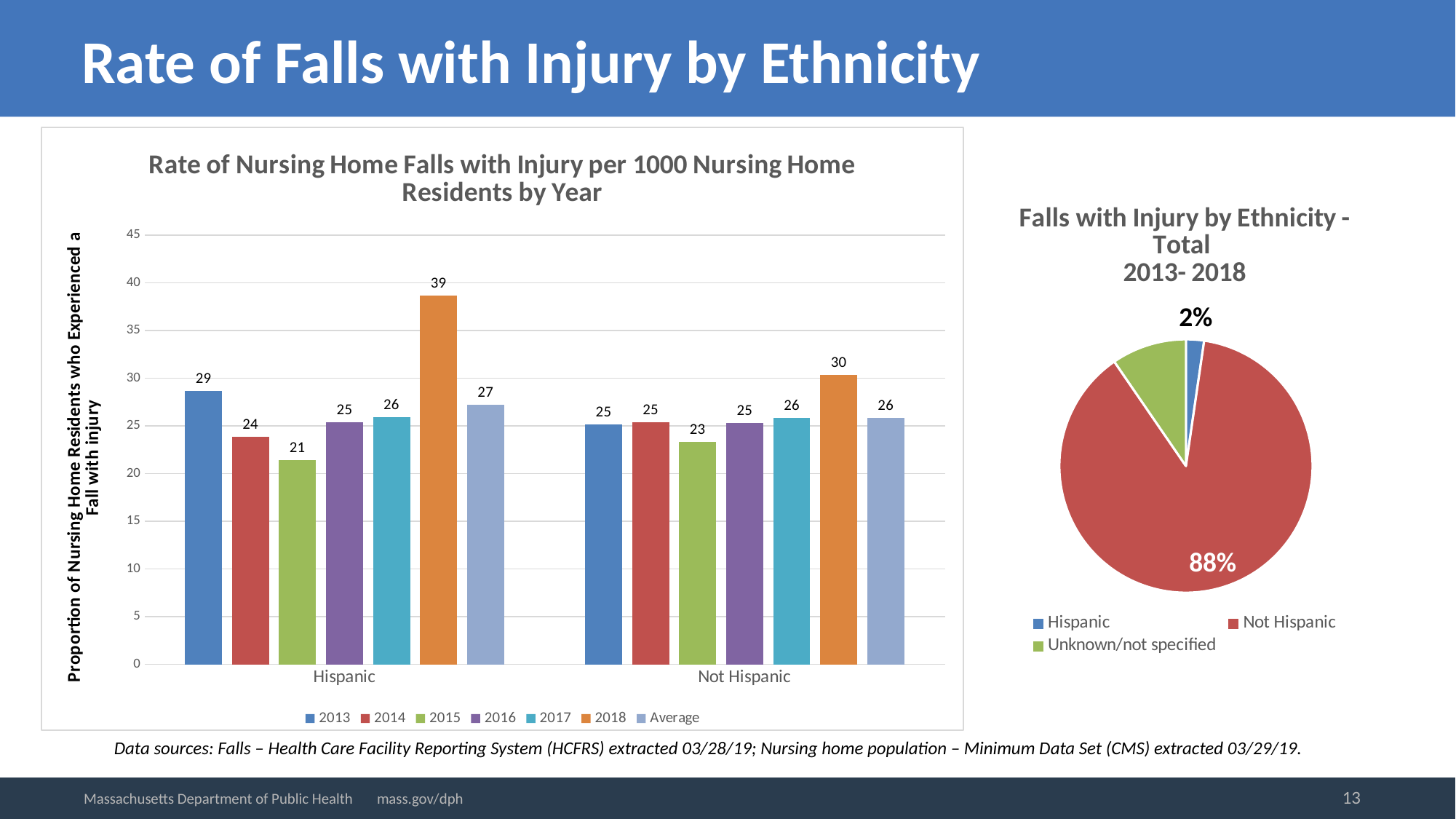
In the pie chart 'Falls with Injury by Ethnicity - Total 2013- 2018', what share is Not Hispanic? 88% In the bar chart 'Rate of Nursing Home Falls with Injury per 1000 Nursing Home Residents by Year', what is the difference between the 2018 values for Hispanic and Not Hispanic? 9 In the bar chart 'Rate of Nursing Home Falls with Injury per 1000 Nursing Home Residents by Year', which year has the lowest value for Hispanic? 2015 How many series does the legend of the bar chart 'Rate of Nursing Home Falls with Injury per 1000 Nursing Home Residents by Year' list? 7 What kind of chart is 'Falls with Injury by Ethnicity - Total 2013- 2018'? pie chart In the bar chart 'Rate of Nursing Home Falls with Injury per 1000 Nursing Home Residents by Year', is the 2018 value for Hispanic greater or less than 35? greater In the bar chart 'Rate of Nursing Home Falls with Injury per 1000 Nursing Home Residents by Year', which year has the highest value for Hispanic? 2018 In the pie chart 'Falls with Injury by Ethnicity - Total 2013- 2018', what share is Hispanic? 2% In the bar chart 'Rate of Nursing Home Falls with Injury per 1000 Nursing Home Residents by Year', what is the Average value for Hispanic? 27 In the bar chart 'Rate of Nursing Home Falls with Injury per 1000 Nursing Home Residents by Year', what is the value for Hispanic in 2018? 39 In the bar chart 'Rate of Nursing Home Falls with Injury per 1000 Nursing Home Residents by Year', what is the value for Not Hispanic in 2015? 23 In the bar chart 'Rate of Nursing Home Falls with Injury per 1000 Nursing Home Residents by Year', which is larger: the 2013 value for Hispanic or the 2013 value for Not Hispanic? Hispanic